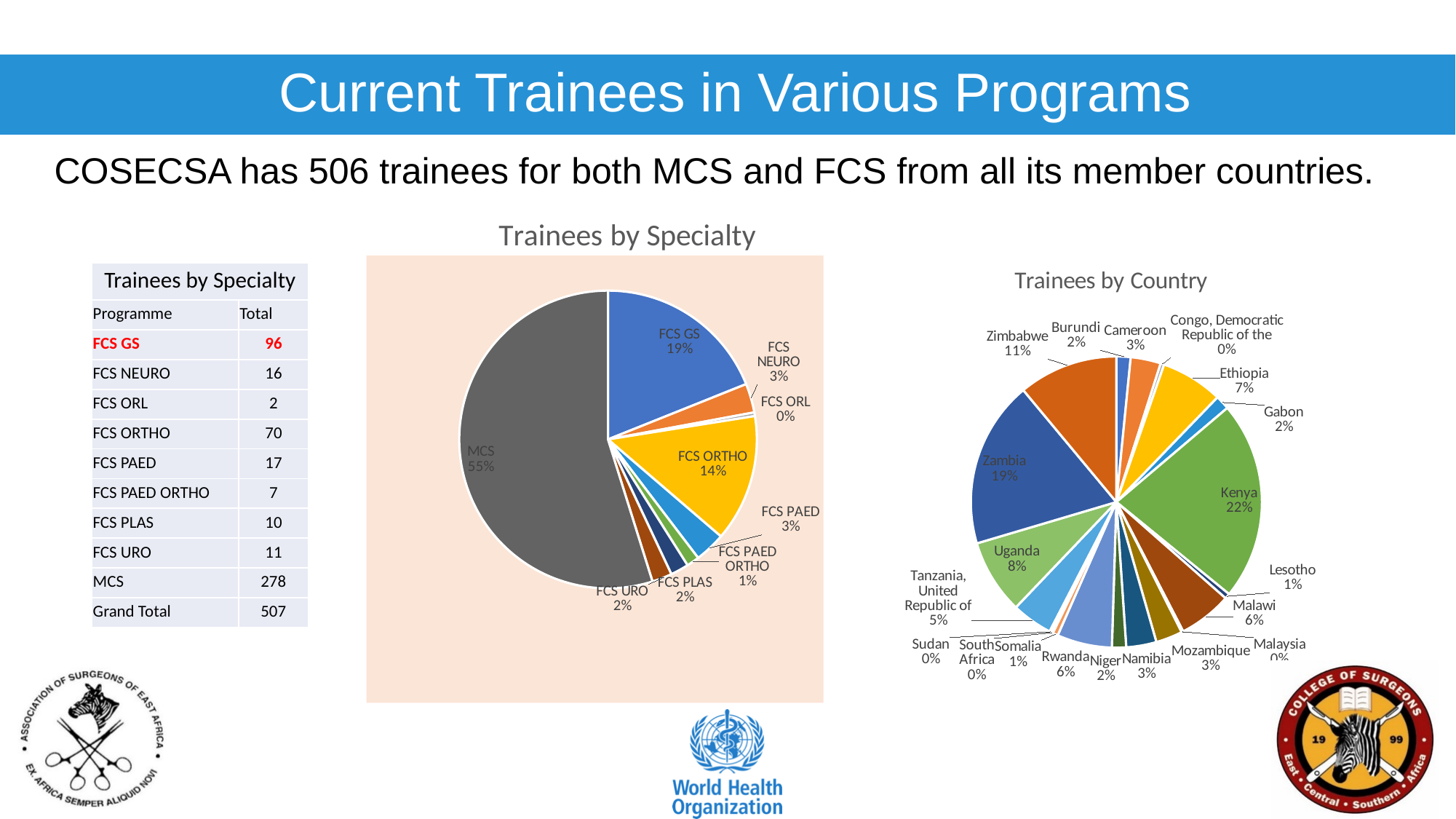
In the 'Trainees by Country' chart, which is larger, Zambia or Zimbabwe? Zambia In the 'Trainees by Specialty' chart, what share of the pie does MCS take? 55% In the 'Trainees by Specialty' chart, which is larger, FCS GS or FCS ORTHO? FCS GS In the 'Trainees by Country' chart, what share of the pie does Kenya take? 22% What kind of chart is the 'Trainees by Specialty' chart? Pie chart What is the title of the pie chart on the right side of the slide? Trainees by Country In the 'Trainees by Specialty' chart, what percentage is shown for FCS ORTHO? 14% In the 'Trainees by Country' chart, what is the difference in percentage points between Kenya and Zambia? 3 percentage points How many slices are labelled in the 'Trainees by Specialty' chart? 9 In the 'Trainees by Country' chart, what percentage is shown for Uganda? 8% In the 'Trainees by Specialty' chart, which specialty has the largest slice? MCS In the 'Trainees by Country' chart, which country has the largest slice? Kenya